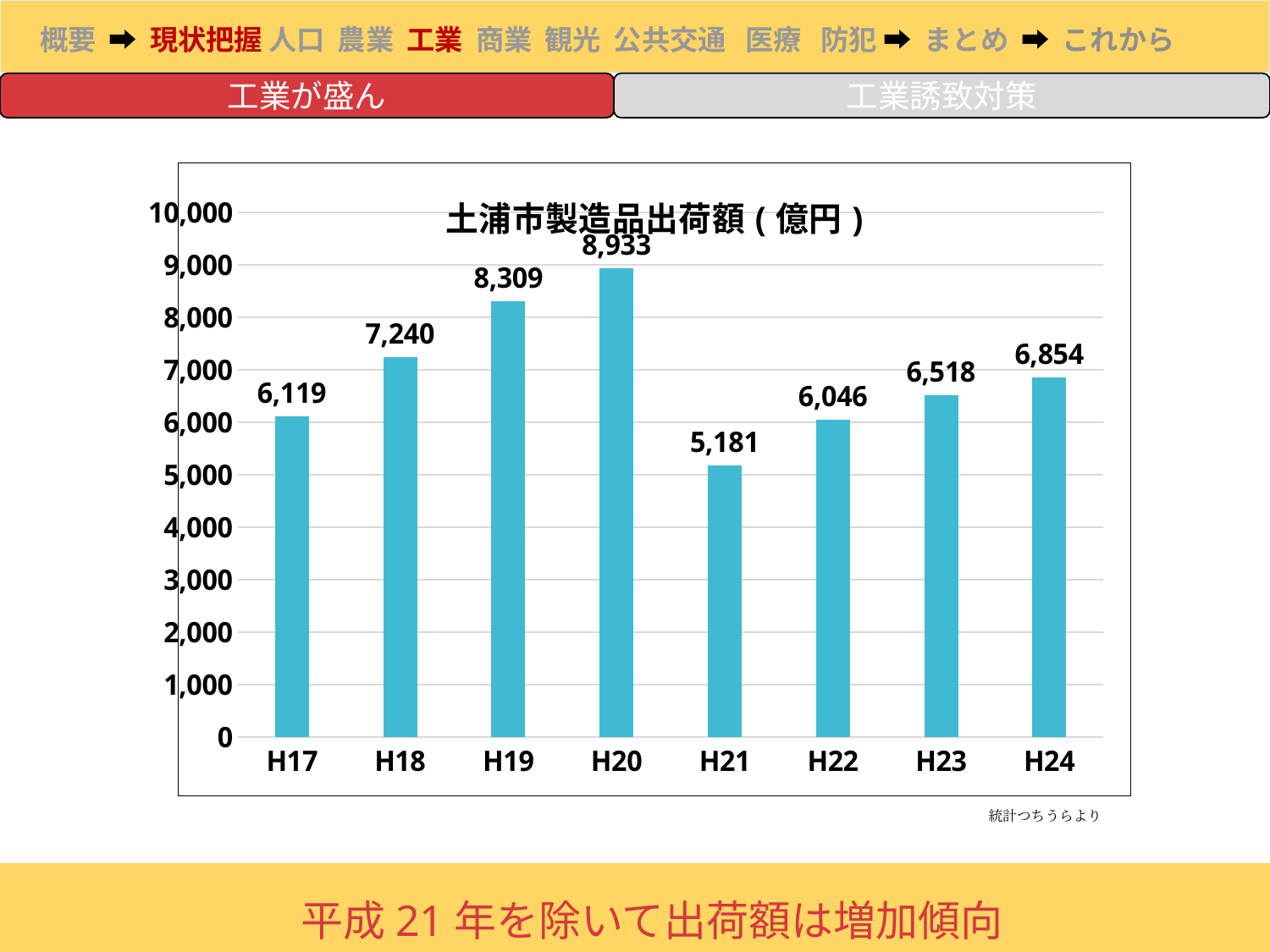
What is the value for H24? 6,854 What is the title of the chart? 土浦市製造品出荷額（億円） Do the values rise or fall from H17 to H20? rise What is the value for H20? 8,933 Which year has the lowest value? H21 What is the difference between the values for H20 and H21? 3,752 Which year has the highest value? H20 Which is larger, the value for H18 or the value for H24? H18 What is the value for H21? 5,181 Is the value for H19 greater or less than 8,000? greater How many years are shown on the x axis? 8 What kind of chart is this? bar chart